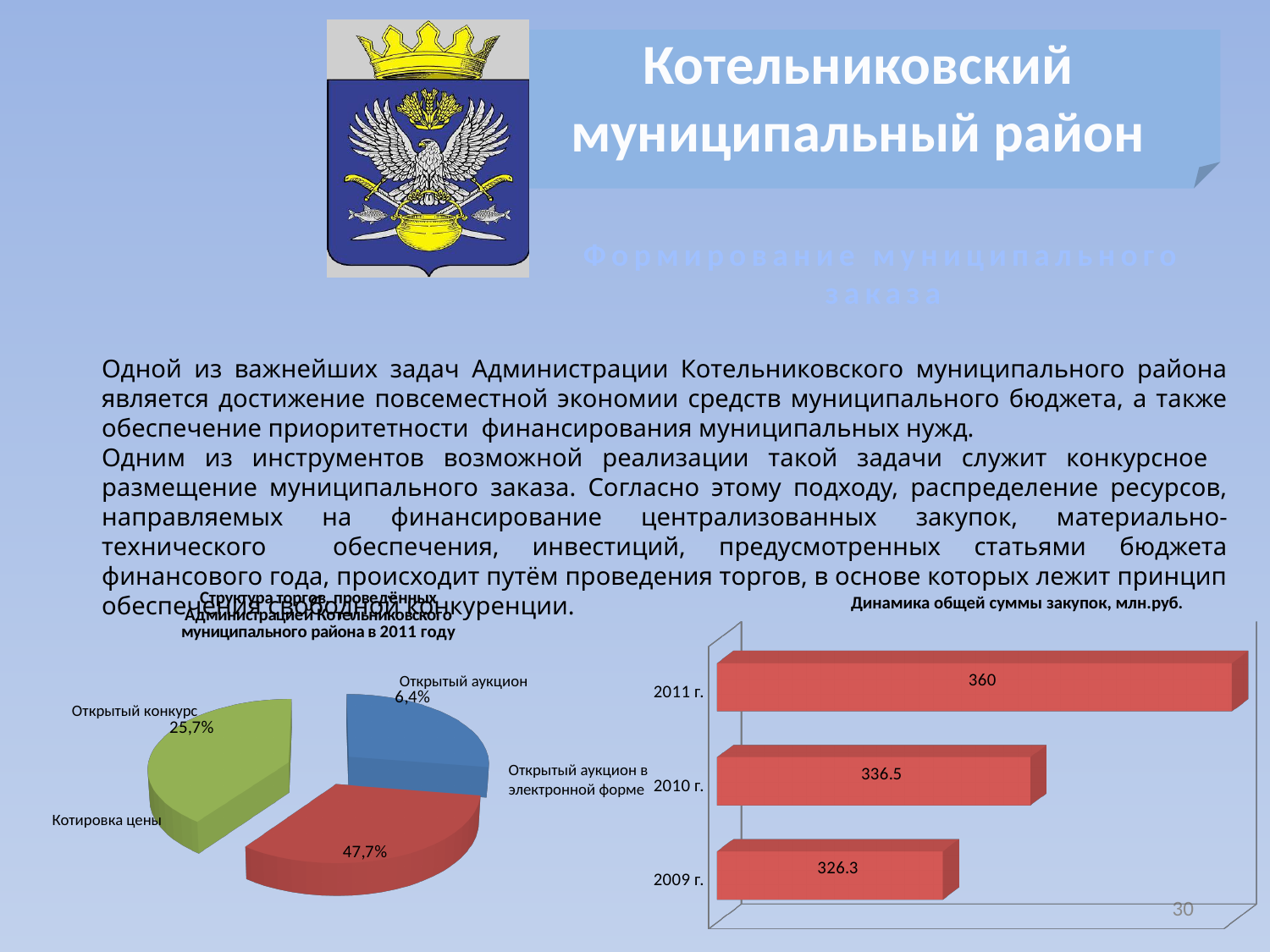
What kind of chart is the one titled 'Динамика общей суммы закупок, млн.руб.'? Bar chart In the chart titled 'Динамика общей суммы закупок, млн.руб.', what is the difference between the values for 2010 г. and 2009 г.? 10.2 In the chart titled 'Динамика общей суммы закупок, млн.руб.', do the values rise or fall from 2009 г. to 2011 г.? Rise In the chart titled 'Динамика общей суммы закупок, млн.руб.', what is the value for 2011 г.? 360 In the chart titled 'Динамика общей суммы закупок, млн.руб.', which is larger, the value for 2010 г. or 2009 г.? 2010 г. In the pie chart on the left of the slide, what share is shown for 'Открытый аукцион'? 6,4% In the chart titled 'Динамика общей суммы закупок, млн.руб.', what is the value for 2010 г.? 336.5 In the chart titled 'Динамика общей суммы закупок, млн.руб.', what is the difference between the values for 2011 г. and 2010 г.? 23.5 In the chart titled 'Динамика общей суммы закупок, млн.руб.', what is the value for 2009 г.? 326.3 How many bars are shown in the chart titled 'Динамика общей суммы закупок, млн.руб.'? 3 In the chart titled 'Динамика общей суммы закупок, млн.руб.', which year has the highest value? 2011 г. In the chart titled 'Динамика общей суммы закупок, млн.руб.', which year has the lowest value? 2009 г.